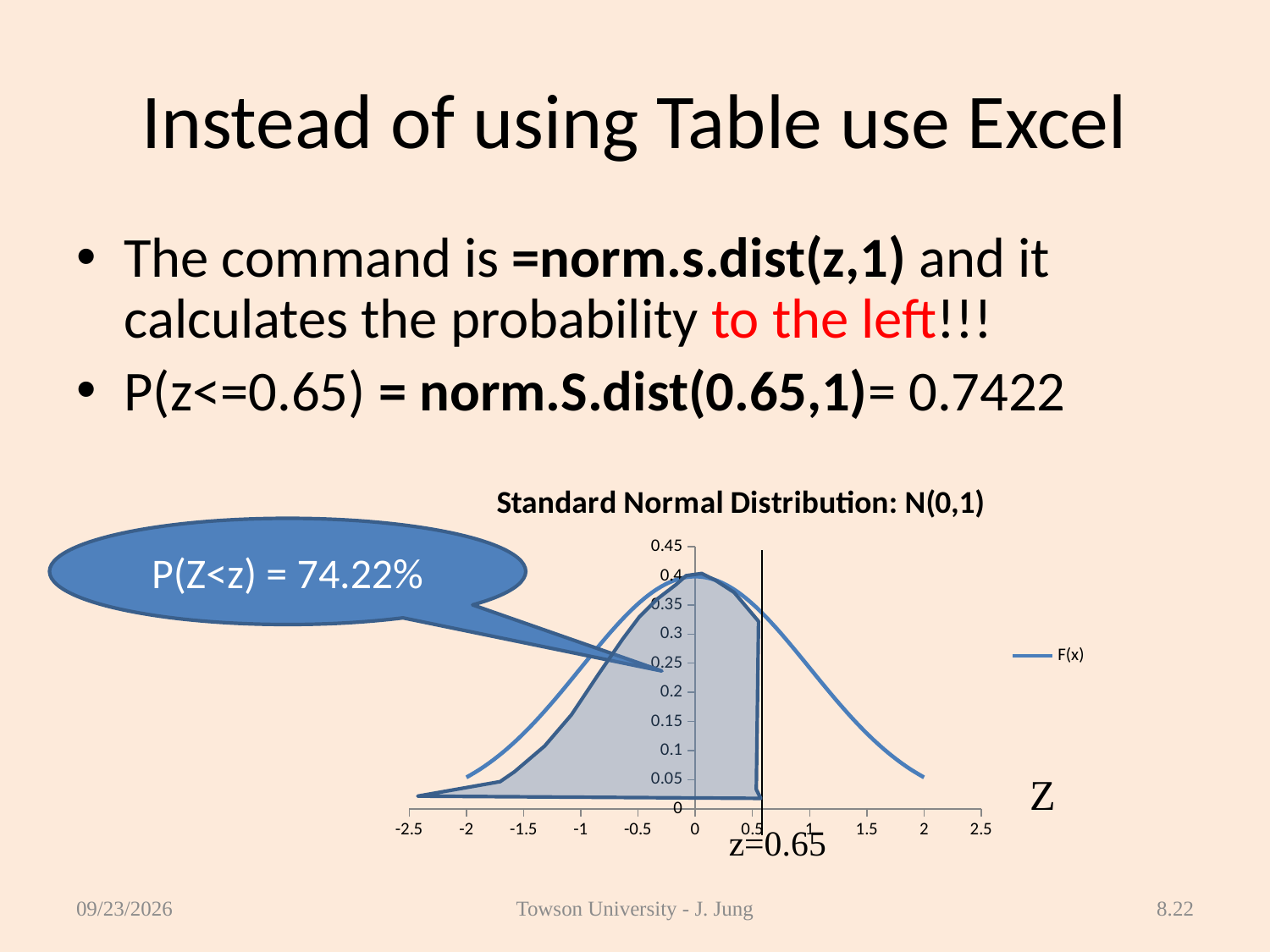
Is the value of F(x) at Z = 2 greater or less than 0.1? less Is the value of F(x) at Z = 0 greater or less than 0.35? greater Is the value of F(x) at Z = -2 greater or less than 0.1? less At which value of Z does the F(x) curve reach its highest point? 0 What probability P(Z<z) is shown in the callout on the chart? 74.22% What is the name of the series shown in the legend? F(x) Which is larger, the value of F(x) at Z = 0 or at Z = 1.5? Z = 0 How many series does the chart's legend list? 1 Does the F(x) curve rise or fall as Z increases from 0 to 2? fall What kind of chart is shown on the slide? line chart Does the F(x) curve rise or fall as Z increases from -2 to 0? rise What is the title of the chart? Standard Normal Distribution: N(0,1)